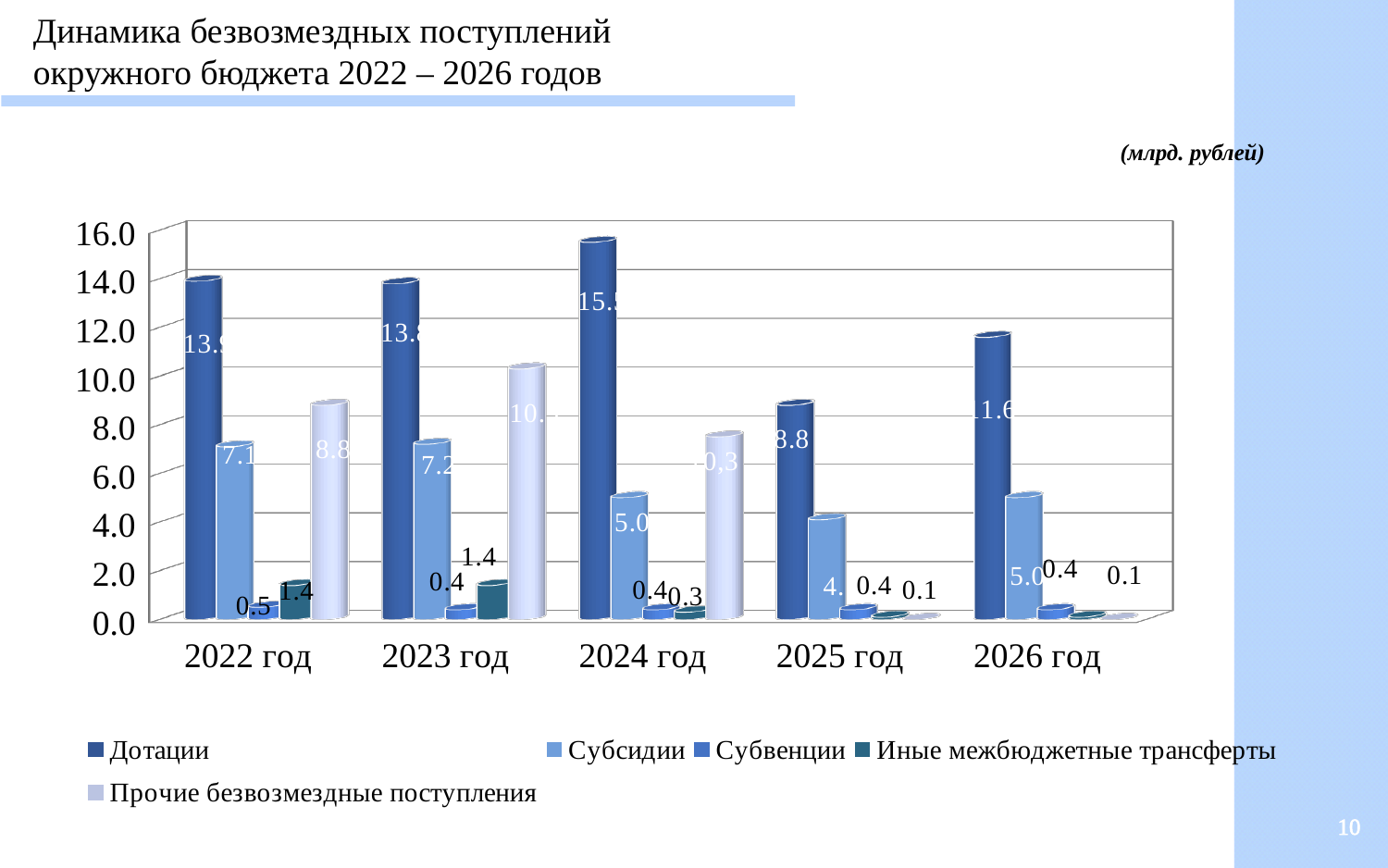
Which is larger in 2022 год: Субсидии or Прочие безвозмездные поступления? Прочие безвозмездные поступления Do the values for Иные межбюджетные трансферты rise or fall from 2022 год to 2026 год? fall What is the value for Дотации in 2025 год? 8.8 What is the value for Субсидии in 2022 год? 7.1 In which year is the value for Дотации the lowest? 2025 год What is the value for Субсидии in 2026 год? 5.0 Is the value for Дотации in 2026 год greater or less than 10.0? greater What is the value for Прочие безвозмездные поступления in 2022 год? 8.8 How many series does the legend list? 5 In which year is the value for Дотации the highest? 2024 год What is the difference between Субсидии in 2023 год and Субсидии in 2022 год? 0.1 What is the value for Иные межбюджетные трансферты in 2024 год? 0.3